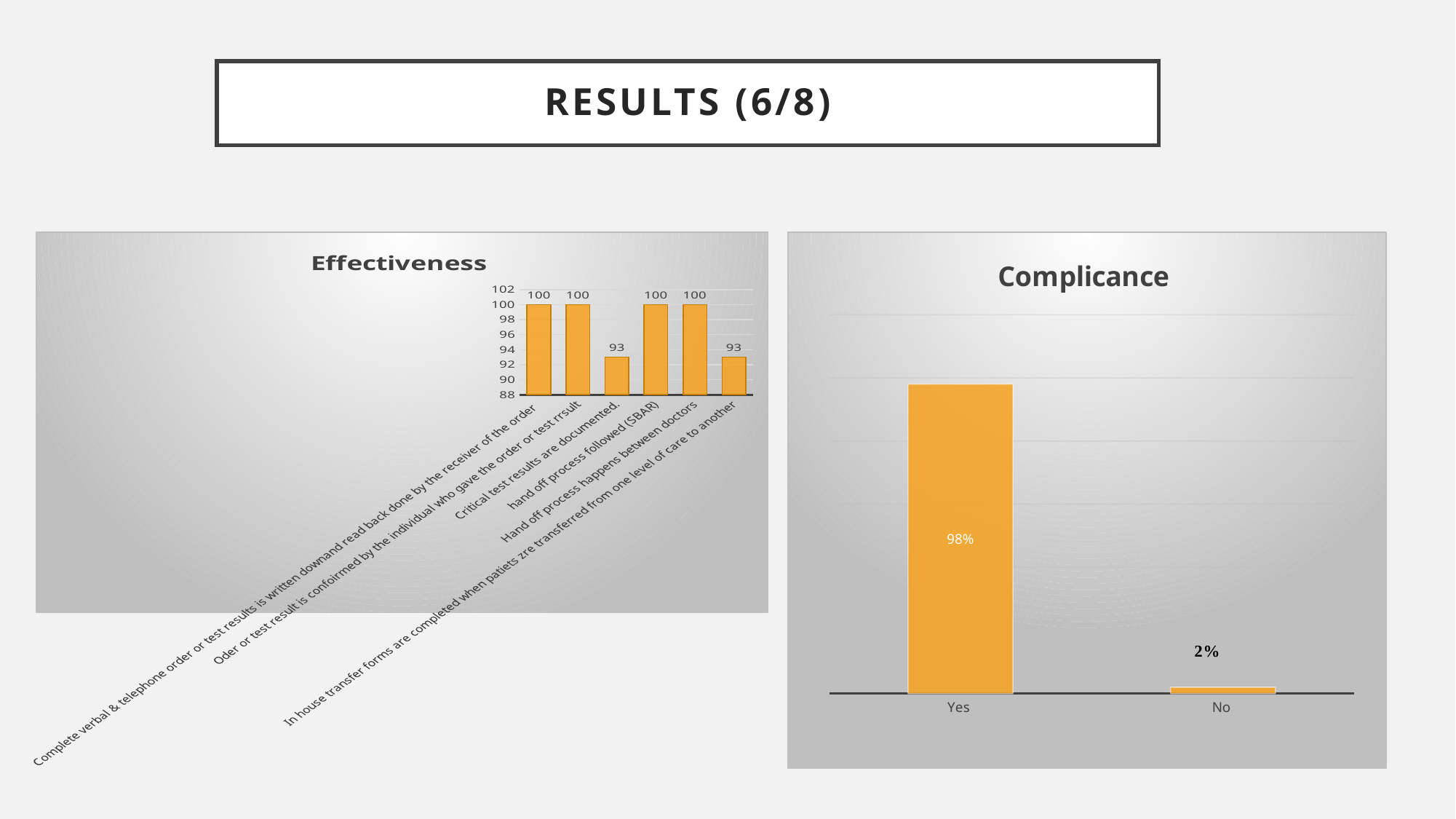
In the Complicance chart, which category has the highest value? Yes In the Effectiveness chart, how many categories are plotted? 6 In the Complicance chart, what is the value for 'No'? 2% In the Complicance chart, what is the difference between the values for 'Yes' and 'No'? 96% In the Effectiveness chart, what is the value for 'hand off process followed (SBAR)'? 100 What kind of chart is the Complicance chart? Bar chart In the Effectiveness chart, what is the value for 'In house transfer forms are completed when patiets zre transferred from one level of care to another'? 93 In the Effectiveness chart, which is larger: the value for 'Oder or test result is confoirmed by the individual who gave the order or test rrsult' or the value for 'Critical test results are documented.'? Oder or test result is confoirmed by the individual who gave the order or test rrsult What is the title of the chart on the left side of the slide? Effectiveness In the Complicance chart, what is the value for 'Yes'? 98% In the Effectiveness chart, what is the difference between the value for 'Hand off process happens between doctors' and the value for 'Critical test results are documented.'? 7 In the Effectiveness chart, what is the value for 'Critical test results are documented.'? 93